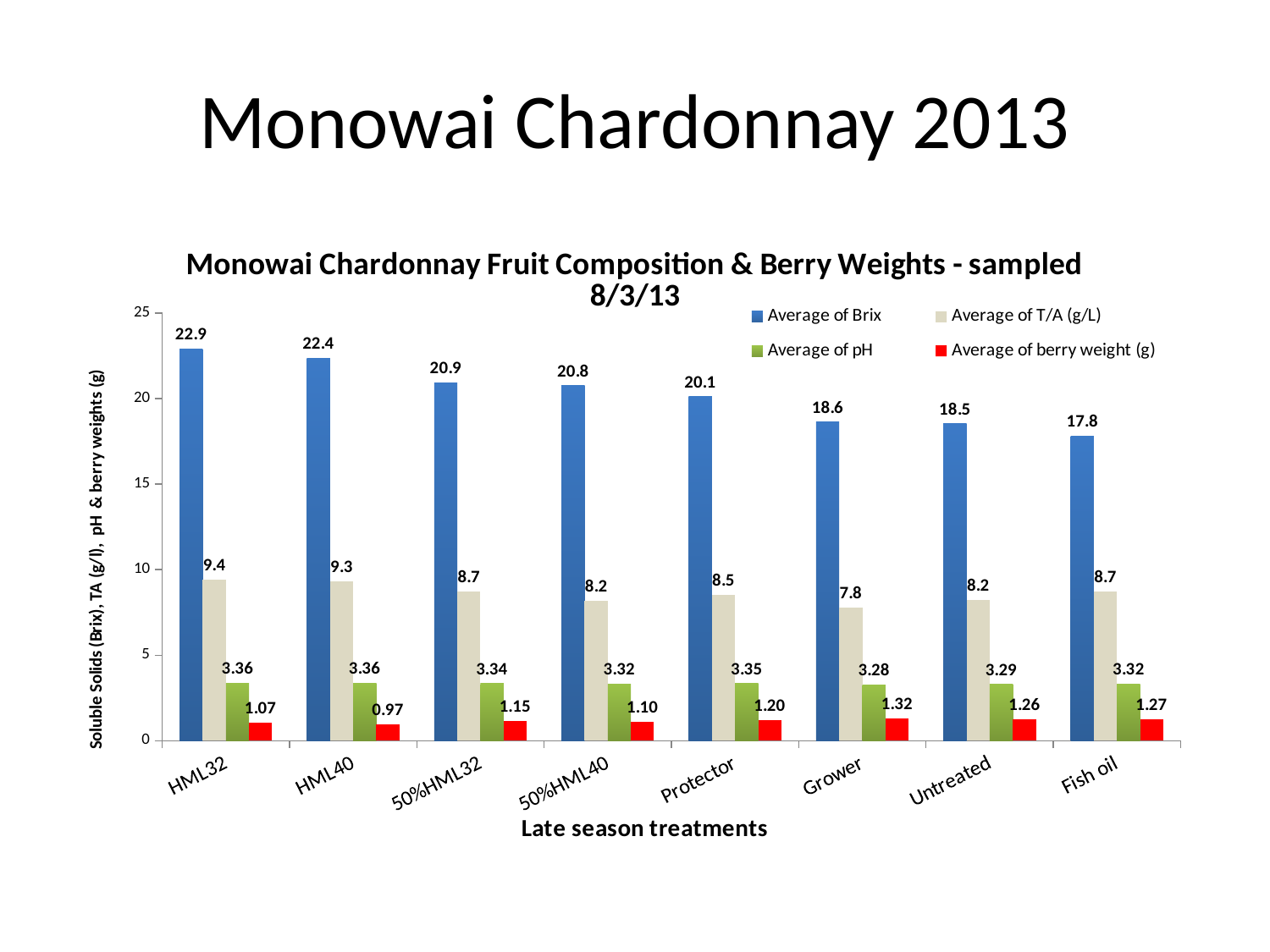
What is the Average of Brix for HML32? 22.9 Which treatment has the lowest Average of berry weight (g)? HML40 Which has a higher Average of T/A (g/L), HML32 or Protector? HML32 How many series does the legend list? 4 What is the Average of berry weight (g) for HML40? 0.97 Which treatment has the highest Average of Brix? HML32 How many late season treatments are shown on the x axis? 8 What is the Average of pH for Untreated? 3.29 What is the Average of T/A (g/L) for Grower? 7.8 What kind of chart is shown? Bar chart Does the Average of Brix rise or fall from HML32 to Fish oil along the x axis? Fall What is the difference in Average of Brix between HML32 and Fish oil? 5.1